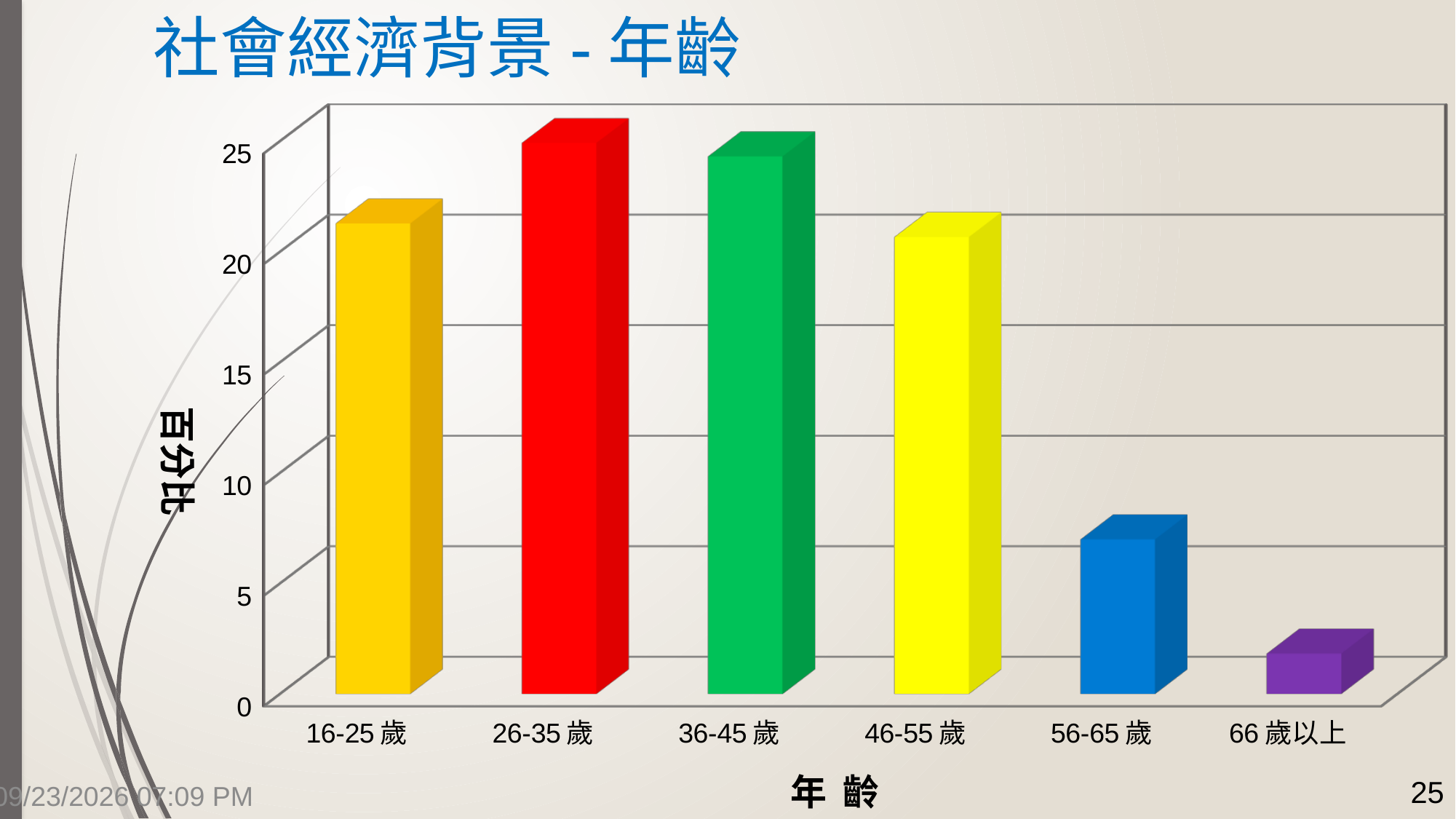
Which is larger, the value for 26-35 歲 or the value for 46-55 歲? 26-35 歲 Is the value for 36-45 歲 greater or less than 20? greater Is the value for 66 歲以上 greater or less than 5? less What colour is the bar for 26-35 歲? red What is the label of the vertical axis? 百分比 What kind of chart is shown on the slide? bar chart Is the value for 16-25 歲 greater or less than 20? greater Which age group has the lowest value? 66 歲以上 Which is larger, the value for 16-25 歲 or the value for 56-65 歲? 16-25 歲 How many age categories are shown on the x axis? 6 Which is larger, the value for 56-65 歲 or the value for 66 歲以上? 56-65 歲